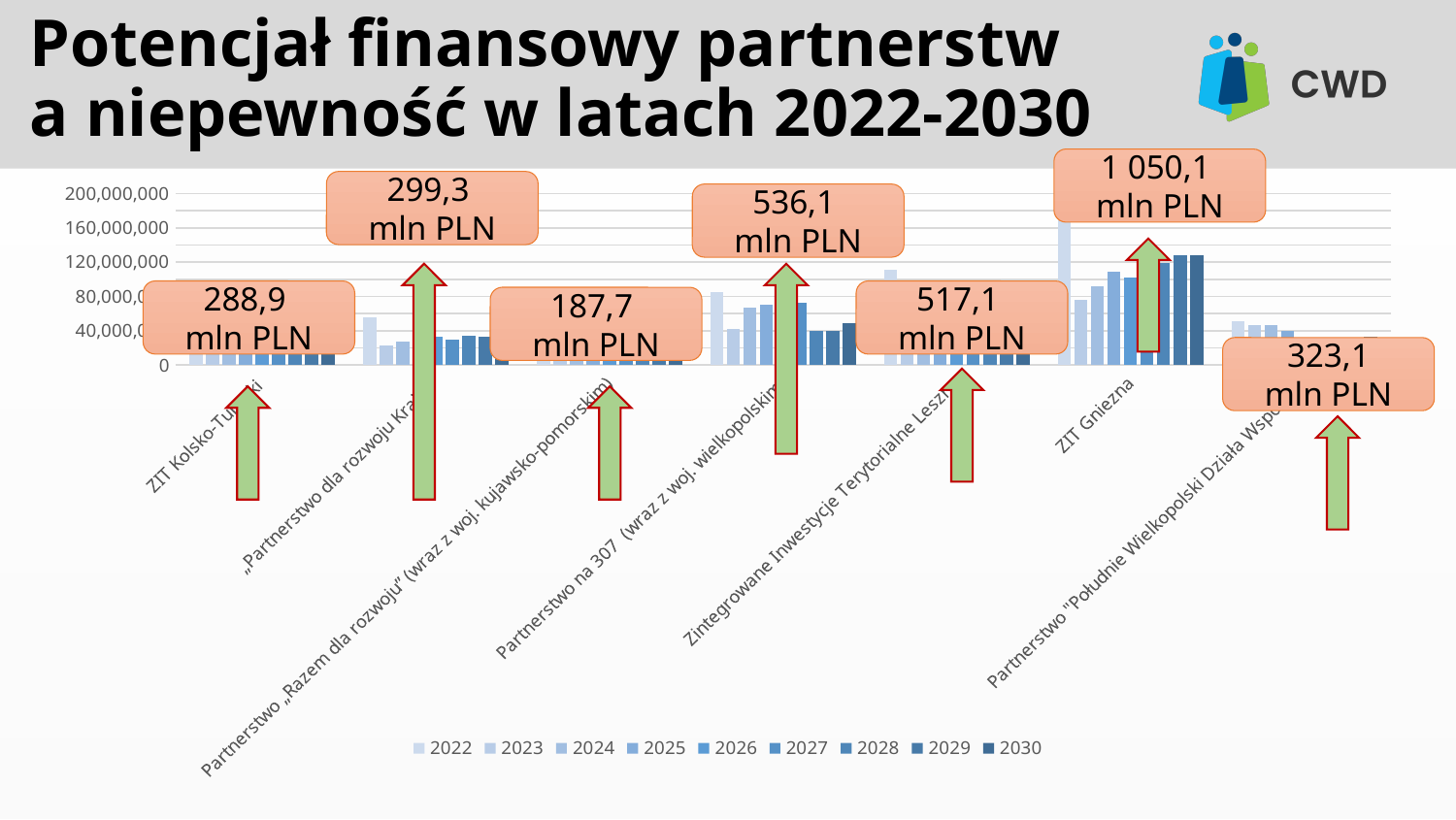
Is the 2022 bar for ZIT Gniezna greater or less than 120,000,000? greater How many series does the legend list? 9 Which partnership has the lowest callout value? Partnerstwo „Razem dla rozwoju" What value does the callout for Partnerstwo „Razem dla rozwoju" show? 187,7 mln PLN What kind of chart is shown on the slide? bar chart What value does the callout for ZIT Kolsko-Turecki show? 288,9 mln PLN How many partnerships (categories) are shown on the x axis? 7 What is the difference between the callout values for Partnerstwo na 307 (536,1 mln PLN) and Zintegrowane Inwestycje Terytorialne Leszno (517,1 mln PLN)? 19,0 mln PLN Which partnership has the highest callout value? ZIT Gniezna What value does the callout above ZIT Gniezna show? 1 050,1 mln PLN What value does the callout for Partnerstwo na 307 show? 536,1 mln PLN What is the highest value shown on the y axis? 200,000,000